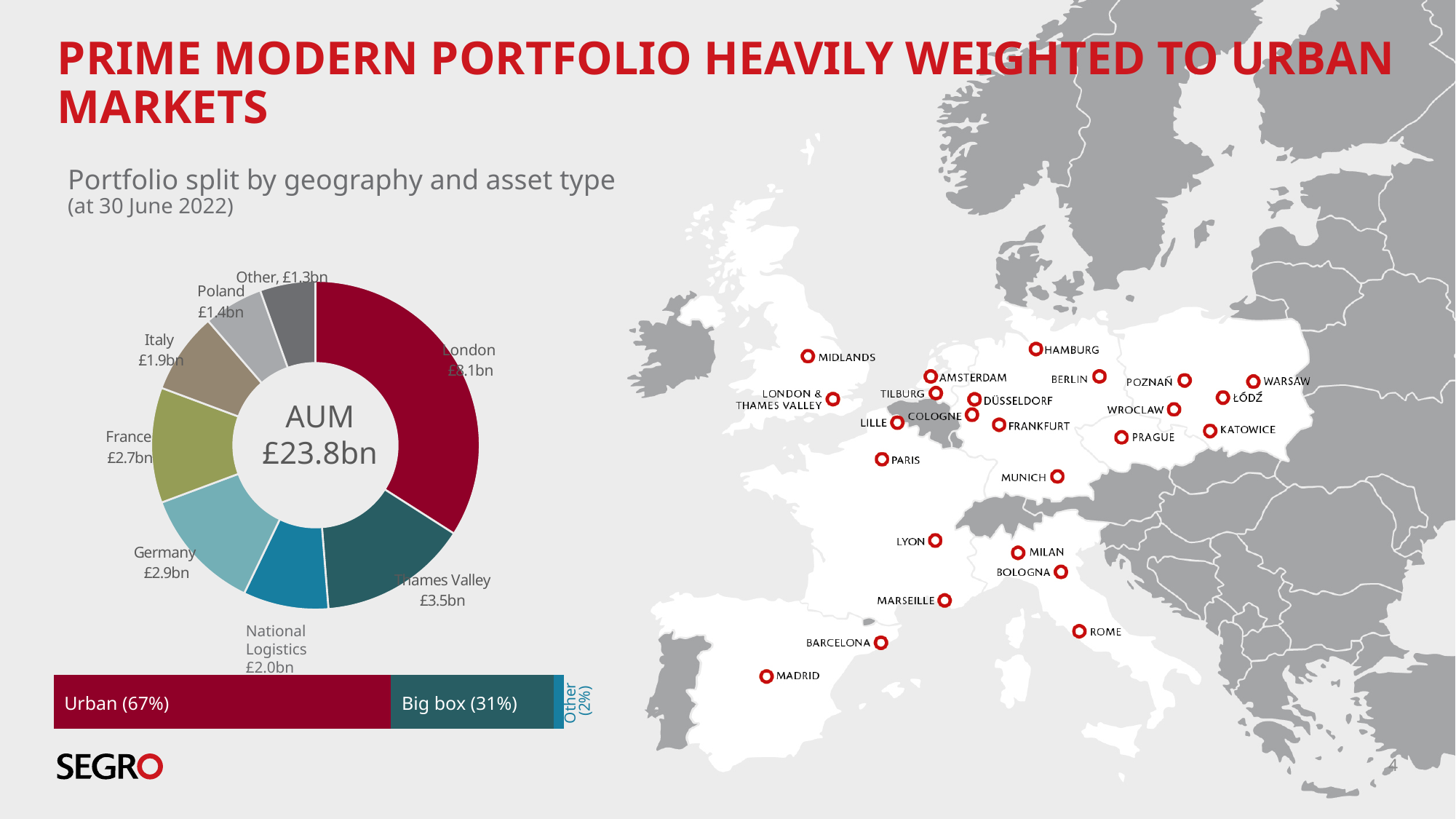
In the donut chart, what is the value for Thames Valley? £3.5bn In the asset type bar at the bottom, what share is Big box? 31% How many segments does the donut chart have? 8 In the donut chart, what is the value for London? £8.1bn In the donut chart, which segment has the largest value? London In the donut chart, what is the difference between the values for London and Thames Valley? £4.6bn In the donut chart, which is larger, the value for France or the value for Italy? France In the asset type bar at the bottom, what share is Urban? 67% In the asset type bar at the bottom, what is the difference between the Urban and Big box shares? 36% In the donut chart, what is the value for Germany? £2.9bn In the donut chart, which segment has the smallest value? Other What total AUM is shown in the centre of the donut chart? £23.8bn